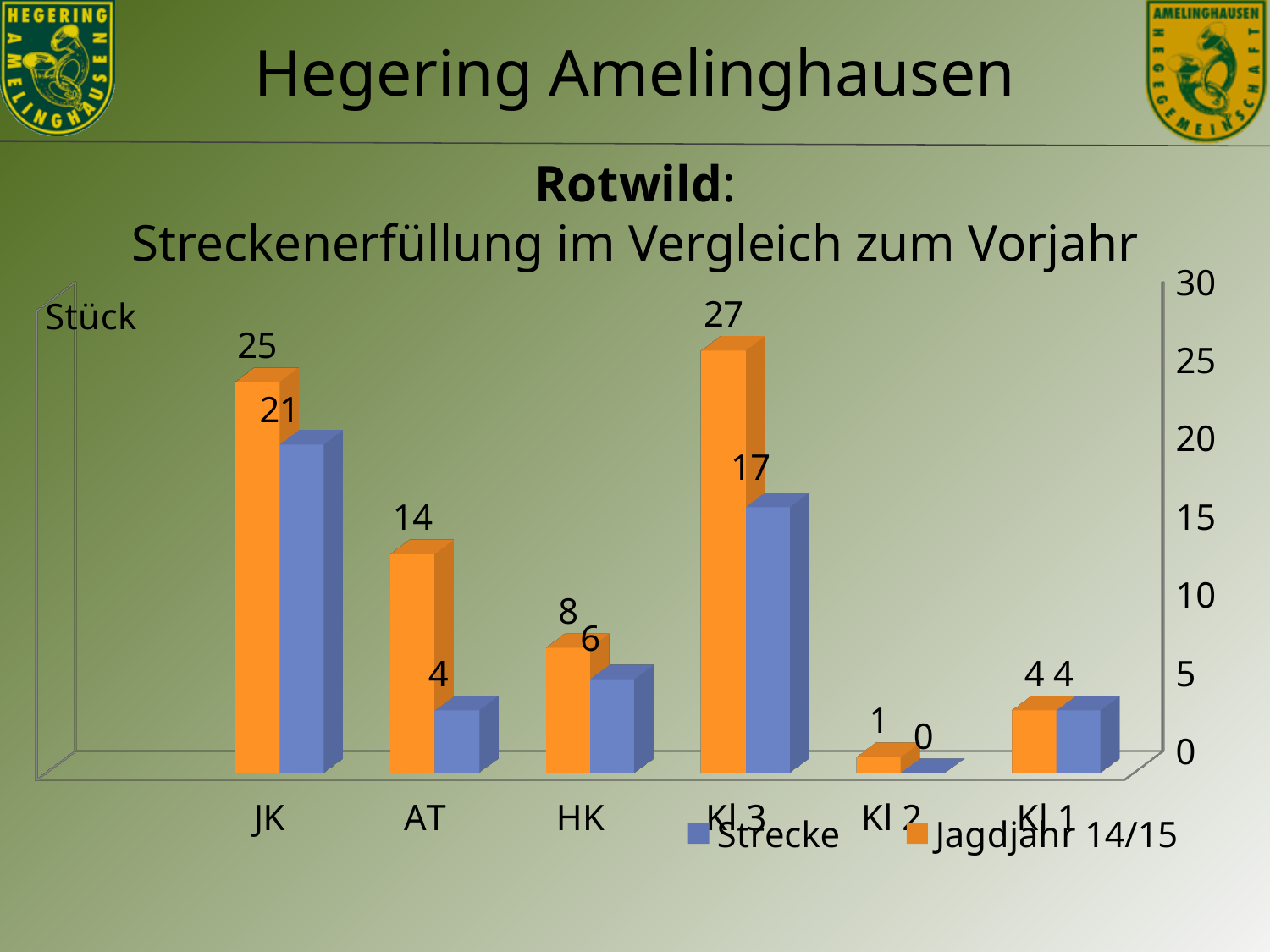
How many series does the legend list? 2 Which category has the highest Jagdjahr 14/15 value? Kl 3 What is the Strecke value for AT? 4 What is the value for Jagdjahr 14/15 in the JK category? 25 Which is larger for HK: the Jagdjahr 14/15 value or the Strecke value? Jagdjahr 14/15 What is the Strecke value for Kl 3? 17 How many categories are shown on the x axis? 6 Which category has the lowest Strecke value? Kl 2 What is the difference between the Jagdjahr 14/15 and Strecke values for AT? 10 What is the difference between the Jagdjahr 14/15 values for Kl 3 and JK? 2 What unit label is shown at the top left of the chart? Stück What kind of chart is shown on the slide? Bar chart